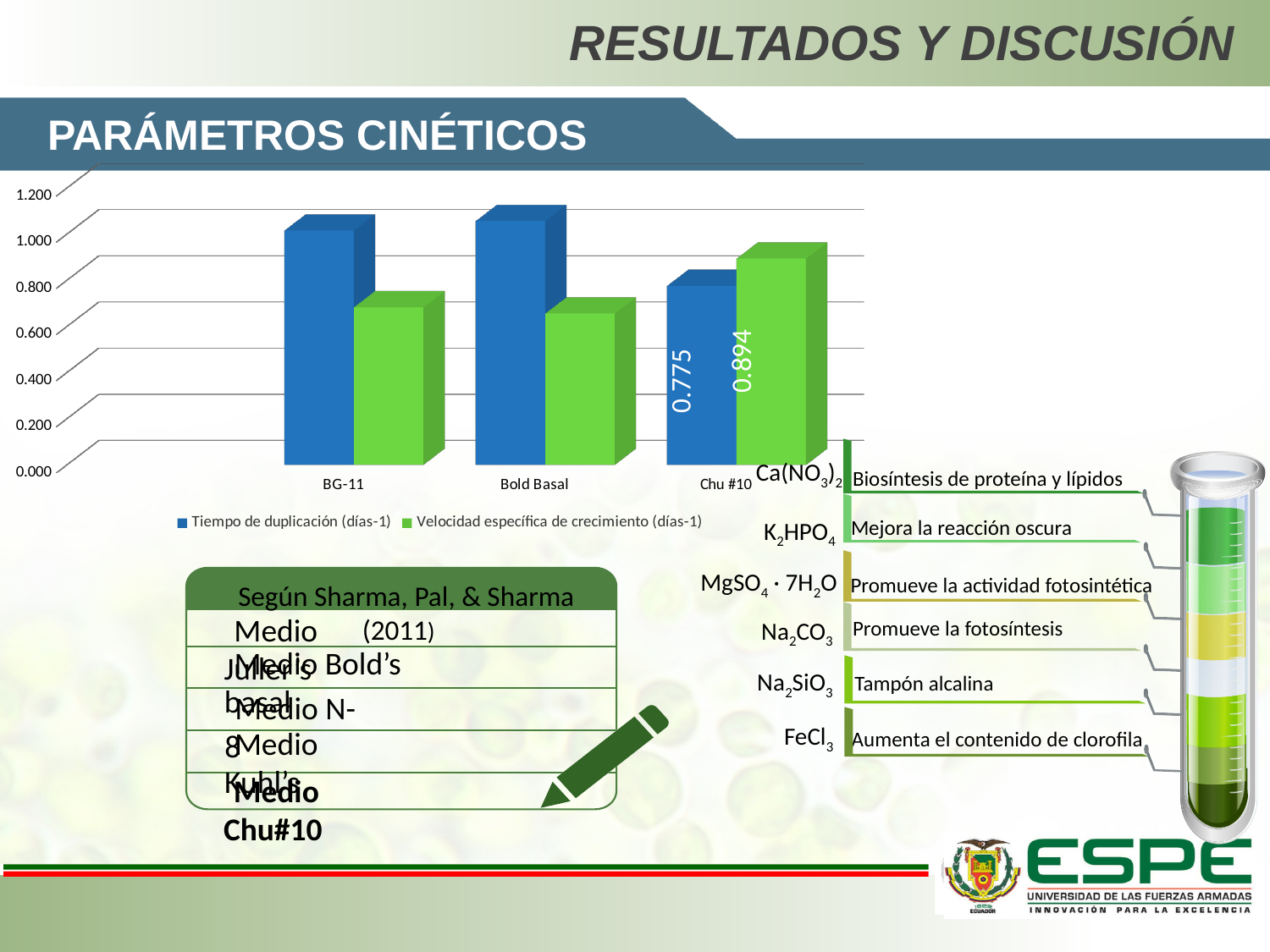
What is the value of Velocidad específica de crecimiento (días-1) for Chu #10? 0.894 Is the value of Velocidad específica de crecimiento (días-1) for Bold Basal greater or less than 0.800? less Which category has the lowest Tiempo de duplicación (días-1)? Chu #10 What is the difference between Velocidad específica de crecimiento and Tiempo de duplicación for Chu #10? 0.119 Which category has the highest Velocidad específica de crecimiento (días-1)? Chu #10 How many categories are shown on the x axis of the chart? 3 What kind of chart is shown on the slide? Bar chart How many series does the chart legend list? 2 For Chu #10, which is larger: Tiempo de duplicación or Velocidad específica de crecimiento? Velocidad específica de crecimiento Is the value of Velocidad específica de crecimiento (días-1) for BG-11 greater or less than 0.400? greater Is the value of Tiempo de duplicación (días-1) for BG-11 greater or less than 0.800? greater What is the value of Tiempo de duplicación (días-1) for Chu #10? 0.775